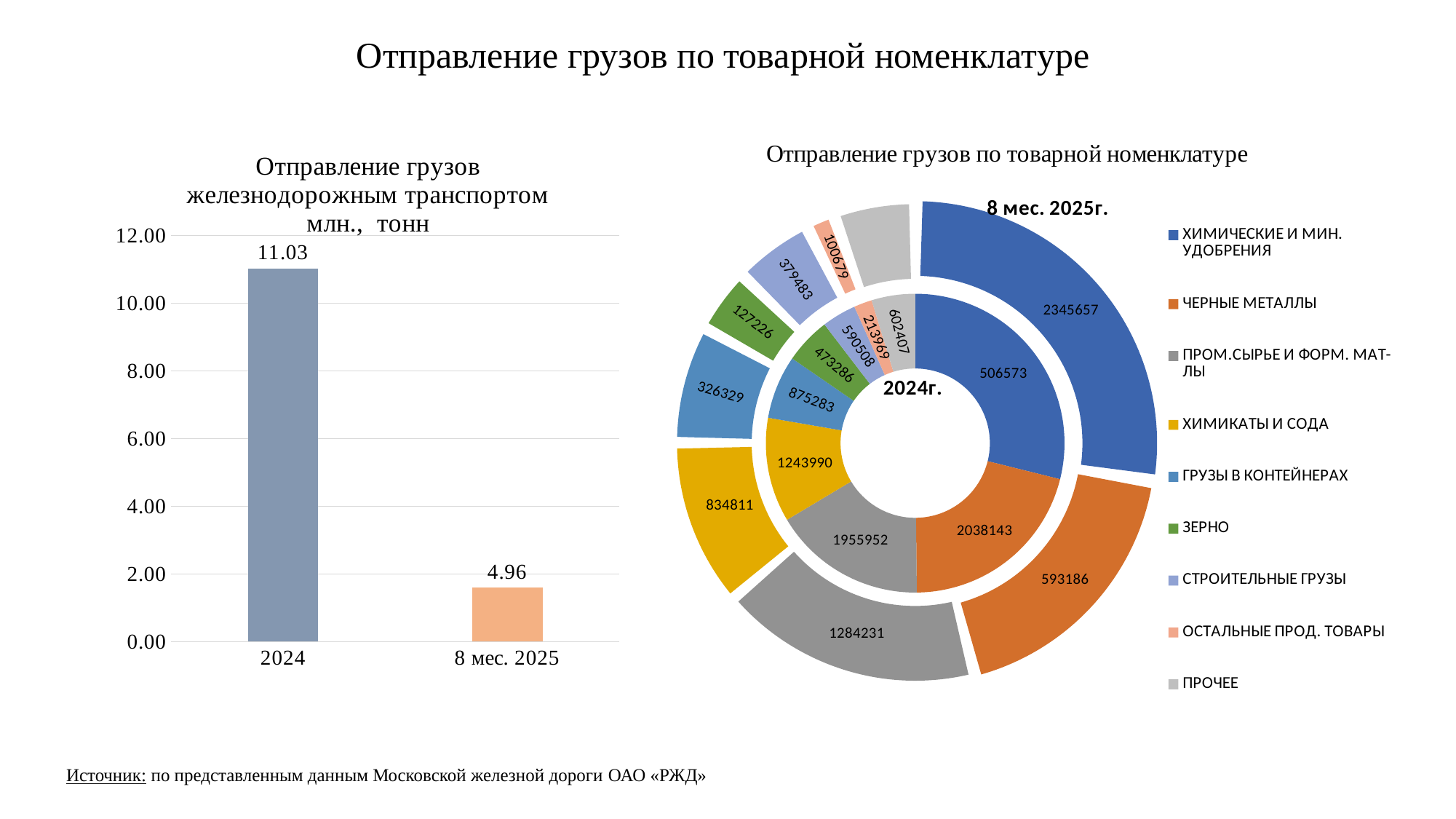
In the right doughnut chart, what is the value for ЗЕРНО in the outer ring (8 мес. 2025г.)? 127226 In the right doughnut chart, which ring represents 2024г., the inner or the outer? inner In the left chart, what is the difference between the 2024 value and the 8 мес. 2025 value? 6.07 In the left chart, what is the value for 8 мес. 2025? 4.96 In the right doughnut chart, what is the value for ХИМИЧЕСКИЕ И МИН. УДОБРЕНИЯ in the outer ring (8 мес. 2025г.)? 2345657 What kind of chart is the left chart? bar chart How many bars are in the left chart? 2 How many categories does the legend of the right doughnut chart list? 9 In the right doughnut chart, what is the value for ЧЕРНЫЕ МЕТАЛЛЫ in the inner ring (2024г.)? 2038143 In the left chart, which category has the higher value, 2024 or 8 мес. 2025? 2024 In the left chart, what is the value for 2024? 11.03 In the right doughnut chart, which category has the largest value in the outer ring (8 мес. 2025г.)? ХИМИЧЕСКИЕ И МИН. УДОБРЕНИЯ